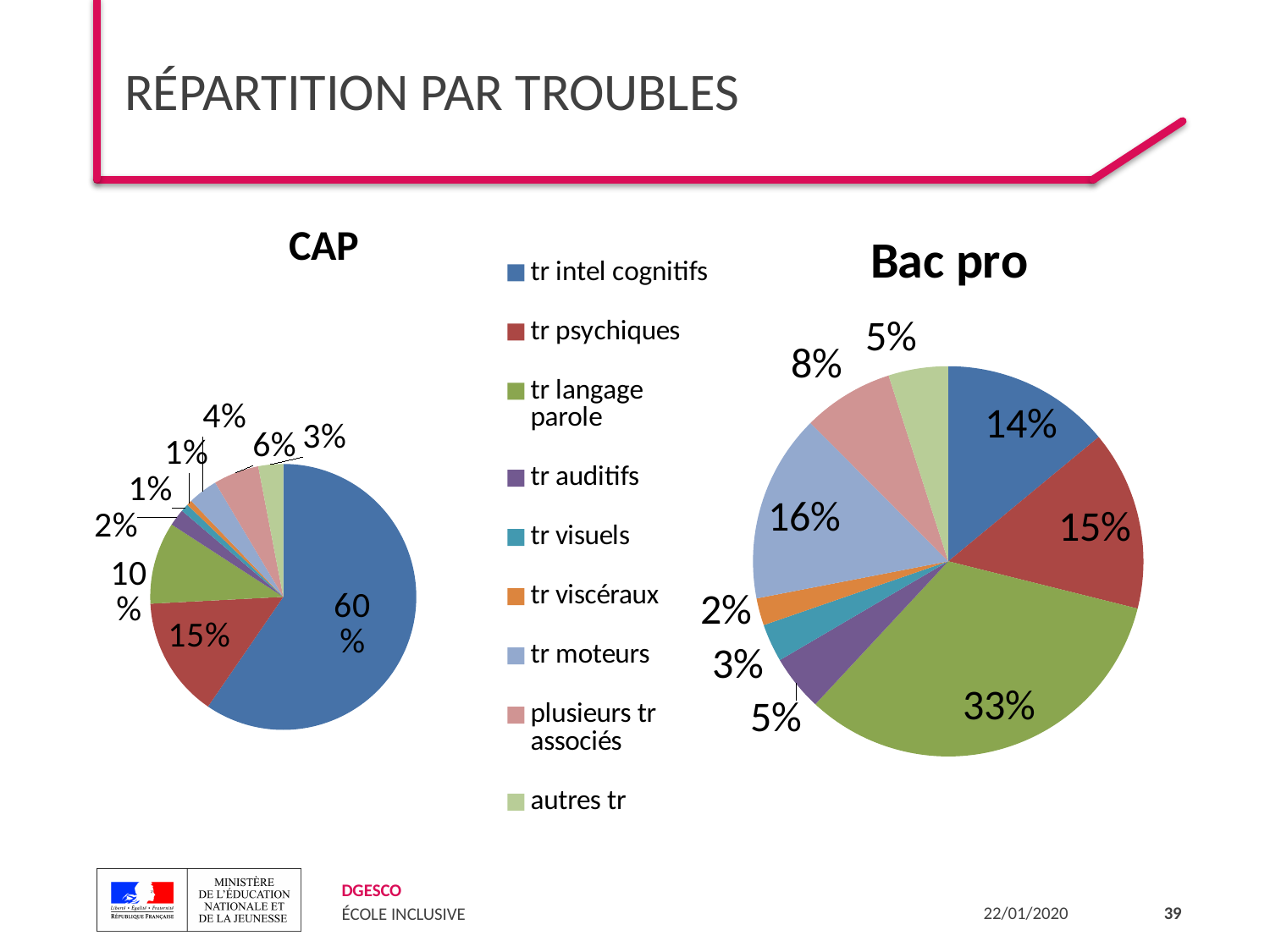
In the CAP chart, what share is shown for tr intel cognitifs? 60% In the Bac pro chart, which category has the smallest slice? tr viscéraux In the Bac pro chart, what share is shown for tr langage parole? 33% What type of chart is used for CAP and Bac pro? Pie chart In the Bac pro chart, which is larger: tr psychiques or tr intel cognitifs? tr psychiques In the CAP chart, which category has the largest slice? tr intel cognitifs How many categories does the legend list? 9 In the CAP chart, what share is shown for plusieurs tr associés? 6% What is the title of the chart on the right? Bac pro In the Bac pro chart, what share is shown for tr moteurs? 16% In the Bac pro chart, which category has the largest slice? tr langage parole What is the difference between the tr intel cognitifs share in the CAP chart and in the Bac pro chart? 46 percentage points